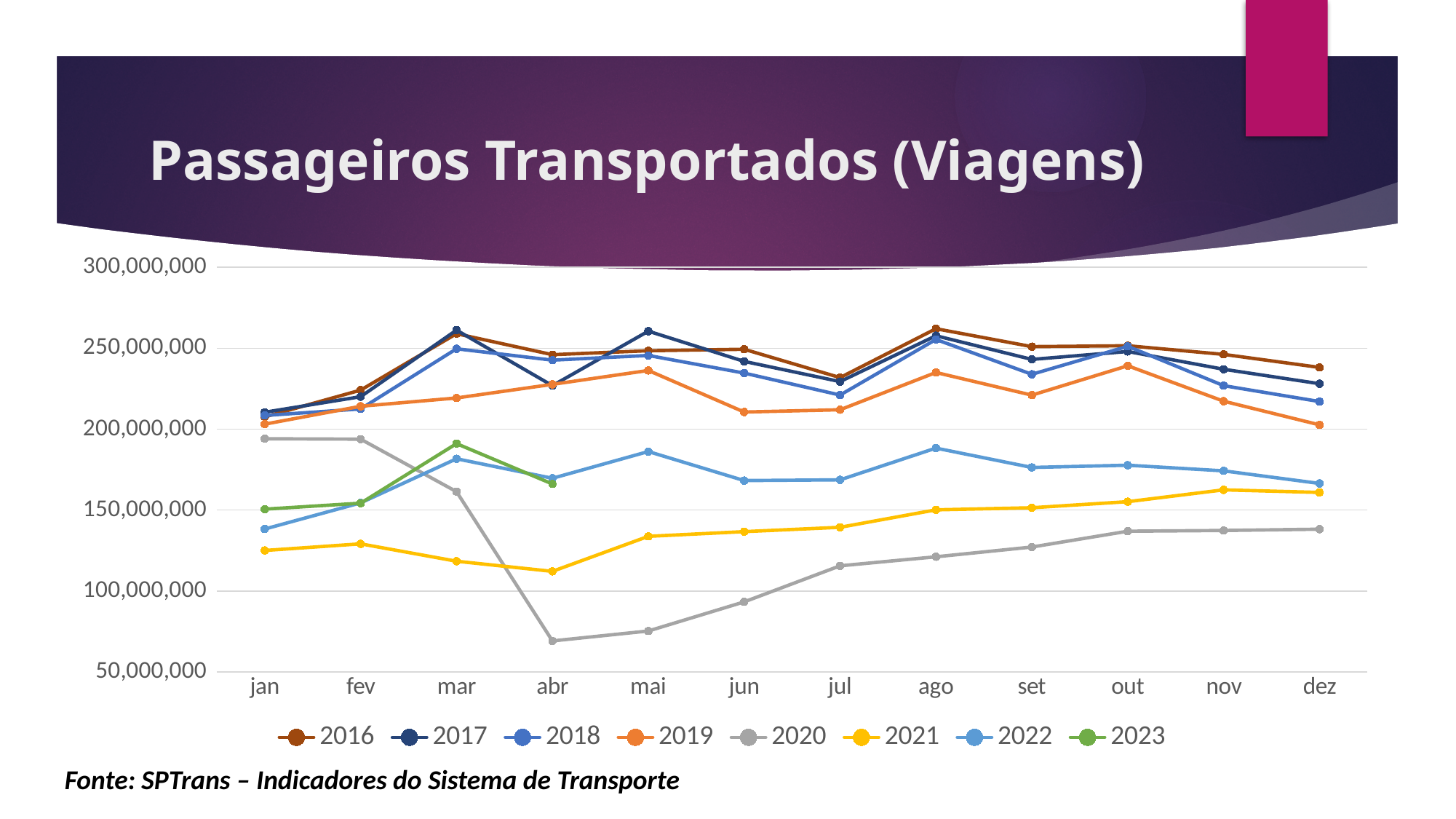
Is the value for 2023 in mar greater or less than 150,000,000? greater Is the value for 2020 in abr greater or less than 100,000,000? less Which series has the highest value in dez? 2016 In abr, which series has the larger value, 2020 or 2021? 2021 Is the value for 2016 in ago greater or less than 250,000,000? greater In jan, which series has the larger value, 2019 or 2022? 2019 How many series does the legend list? 8 How many months are shown along the x axis? 12 Does the 2020 series rise or fall from jan to abr? fall In which month does the 2020 series reach its lowest value? abr What kind of chart is shown on the slide? line chart What is the title of the chart? Passageiros Transportados (Viagens)